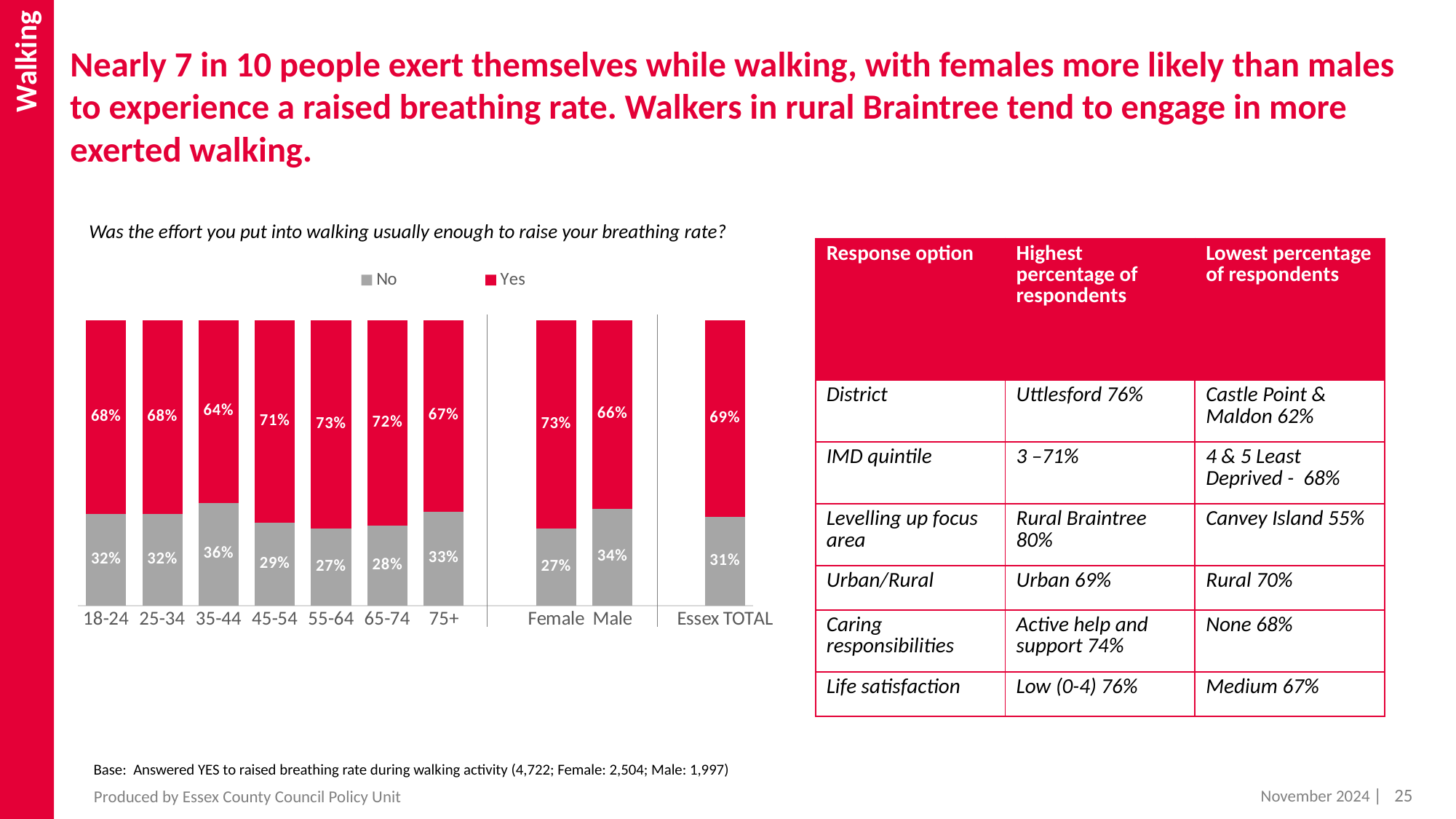
How many categories are shown on the x axis of the chart? 10 What kind of chart is shown on the slide? Stacked bar chart What is the difference between the No percentage for 35-44 and the No percentage for 55-64? 9 percentage points What is the Yes percentage for Essex TOTAL? 69% What percentage of 55-64 year olds answered Yes? 73% How many percentage points higher is the Yes value for Female than for Male? 7 percentage points Which has a higher Yes percentage, 45-54 or 75+? 45-54 How many series does the legend list? 2 Which category has the lowest Yes percentage? 35-44 Which age group has the highest Yes percentage? 55-64 What colour represents the Yes series in the chart? Red What percentage of males answered No? 34%